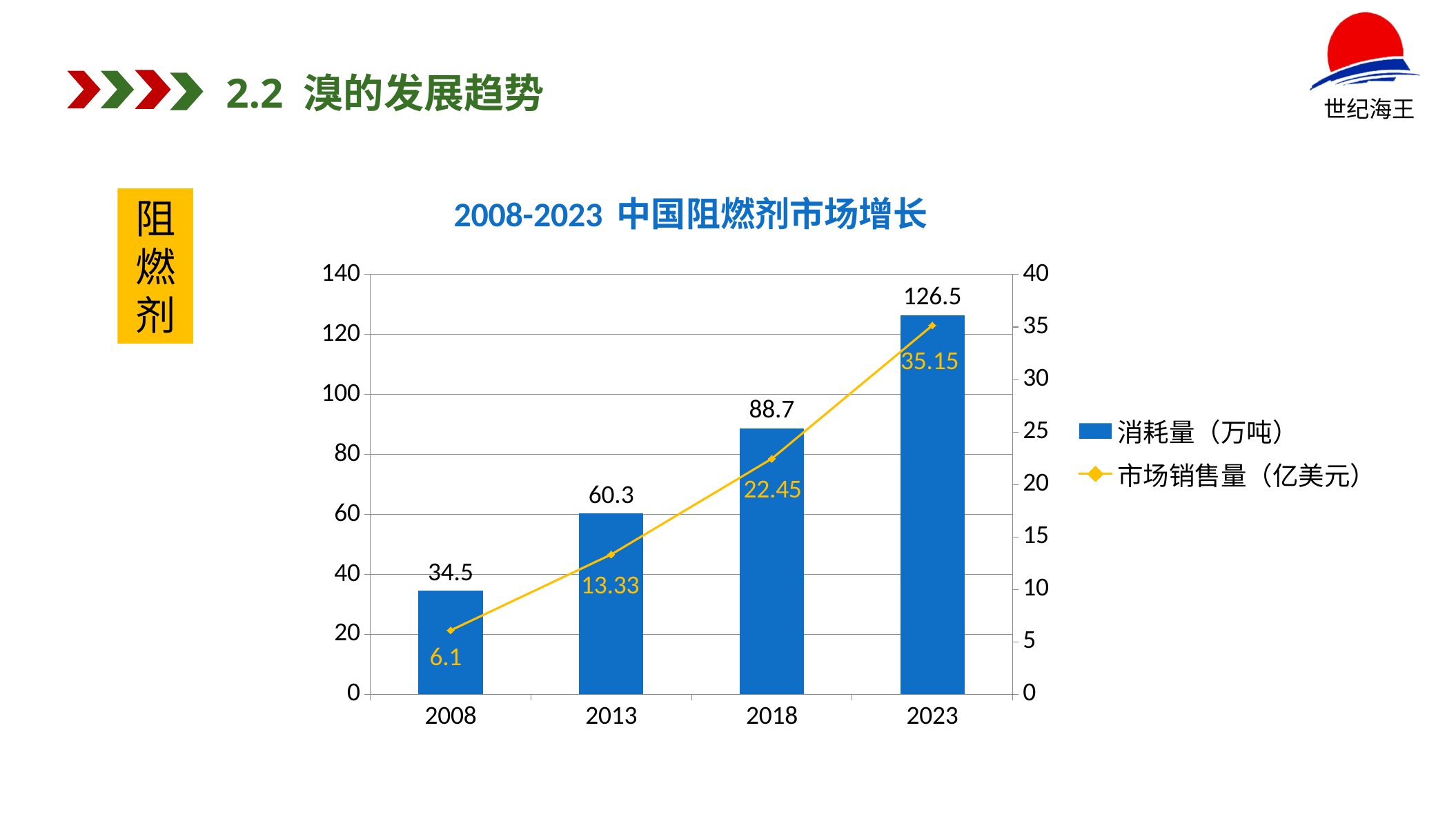
What is the 市场销售量（亿美元） value for 2023? 35.15 Does the 消耗量（万吨） rise or fall from 2008 to 2023? rise What is the 消耗量（万吨） value for 2008? 34.5 Which year has the lowest 市场销售量（亿美元）? 2008 How many years are shown on the x axis? 4 Which year has the highest 消耗量（万吨）? 2023 What is the difference in 消耗量（万吨） between 2023 and 2018? 37.8 What is the 消耗量（万吨） value for 2018? 88.7 Which is larger, the 市场销售量（亿美元） for 2018 or for 2013? 2018 What is the title of the chart? 2008-2023 中国阻燃剂市场增长 How many series does the legend list? 2 What is the 市场销售量（亿美元） value for 2013? 13.33